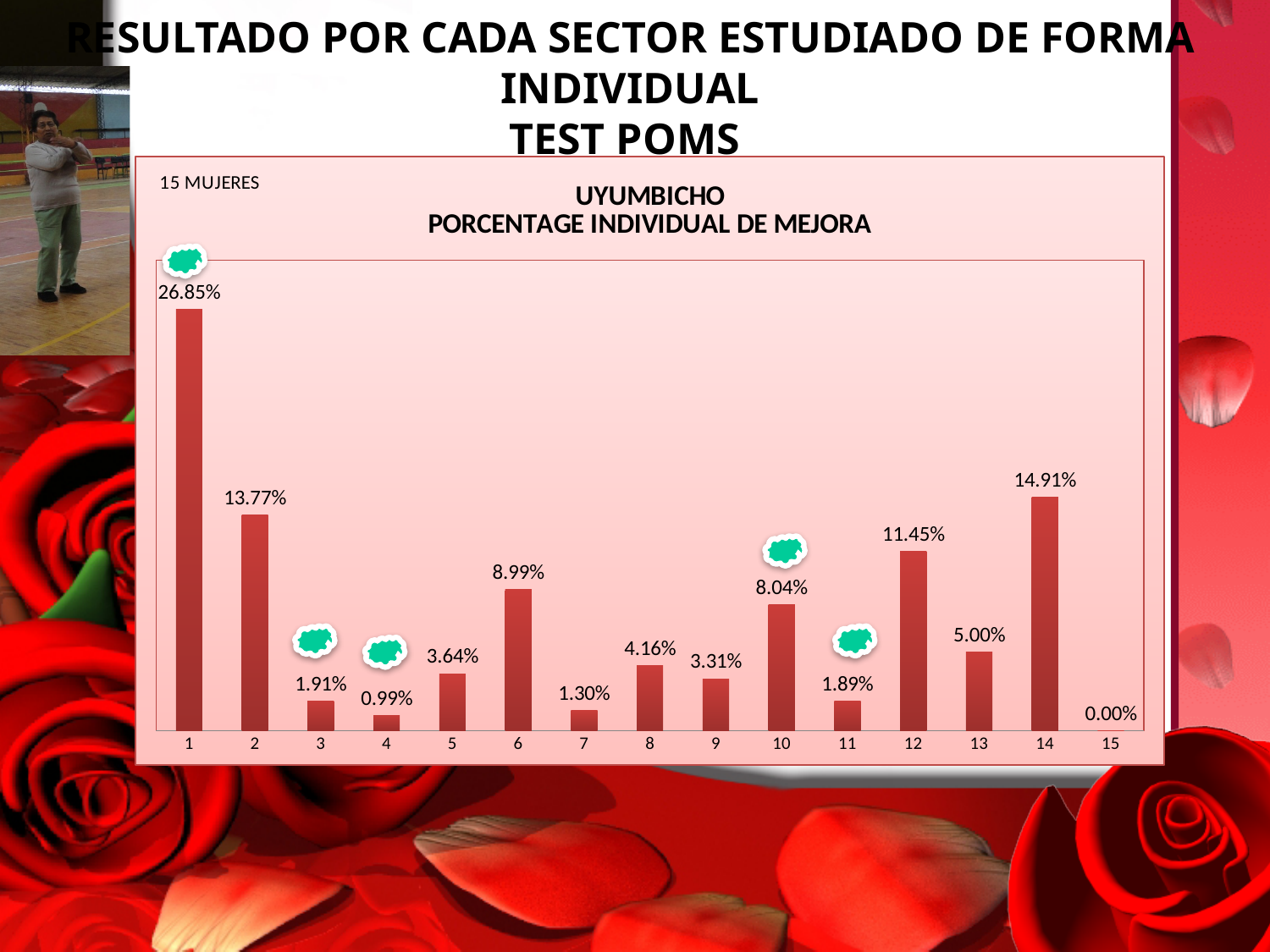
Which category has the lowest value? 15 What is the title of the chart? UYUMBICHO PORCENTAGE INDIVIDUAL DE MEJORA What is the value for category 6? 8.99% How many categories are shown on the x axis? 15 Which is larger, the value for category 12 or the value for category 14? 14 What is the difference between the values for category 12 and category 13? 6.45% What is the value for category 11? 1.89% What is the difference between the values for category 1 and category 2? 13.08% Which category has the highest value? 1 What kind of chart is shown on the slide? bar chart What is the value for category 14? 14.91% What is the value for category 1? 26.85%